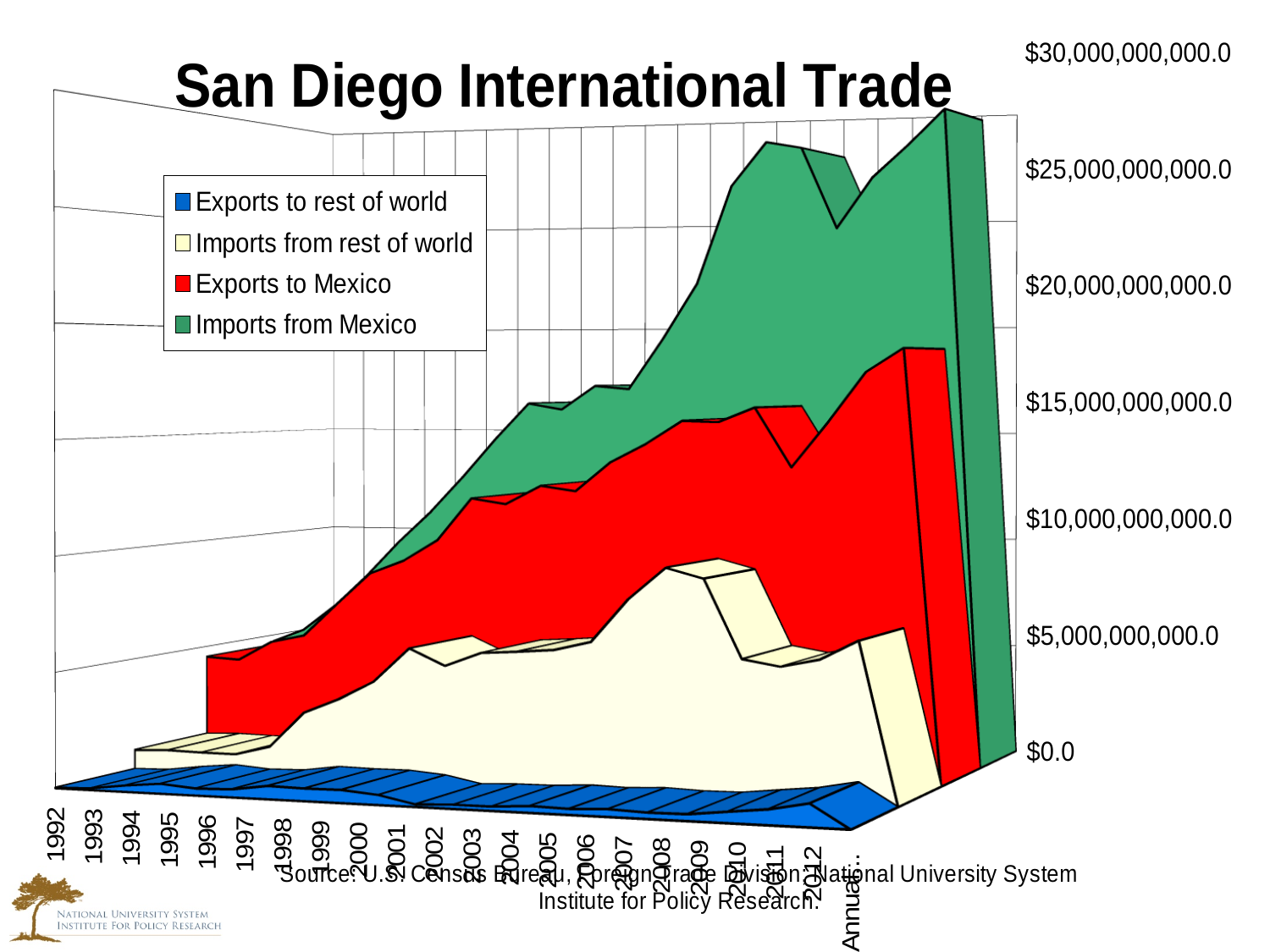
Which colour represents Exports to Mexico in the chart? Red What kind of chart is shown on the slide? Area chart How many series does the legend list? 4 What is the highest value shown on the vertical axis? $30,000,000,000.0 What is the first year shown on the horizontal axis? 1992 Which series is plotted as the smallest band in the chart? Exports to rest of world Does the total stacked value generally rise or fall from 1992 to 2012? Rise What is the title of the chart? San Diego International Trade